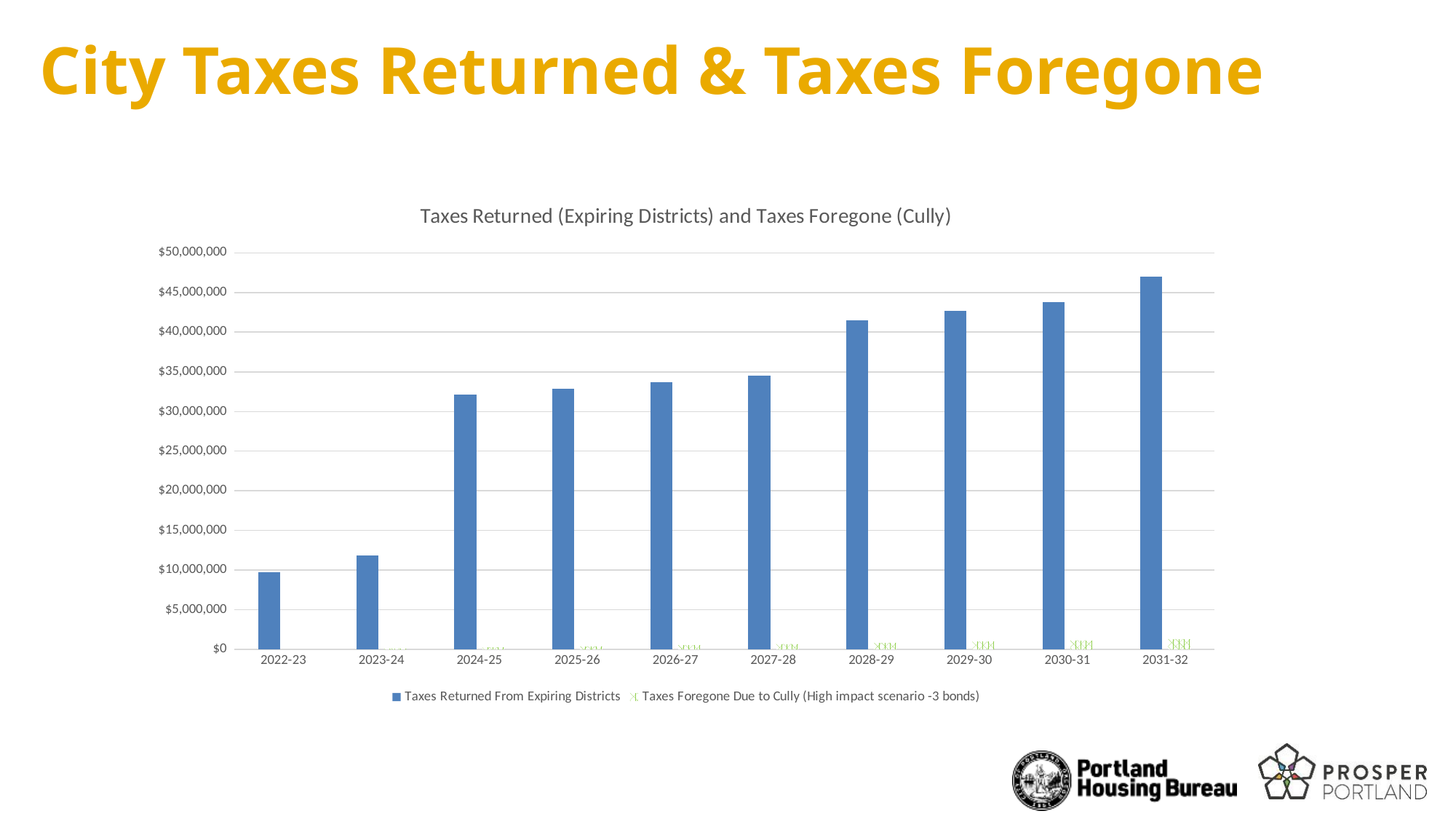
Which is larger for Taxes Returned From Expiring Districts: 2027-28 or 2028-29? 2028-29 Is the value for Taxes Returned From Expiring Districts in 2022-23 greater or less than $15,000,000? less Which fiscal year has the highest value for Taxes Returned From Expiring Districts? 2031-32 Is the value for Taxes Returned From Expiring Districts in 2030-31 greater or less than $45,000,000? less How many series does the chart's legend list? 2 How many fiscal years are shown on the x axis of the chart? 10 What kind of chart is shown on the slide? Bar chart Is the value for Taxes Returned From Expiring Districts in 2024-25 greater or less than $30,000,000? greater What is the title of the chart? Taxes Returned (Expiring Districts) and Taxes Foregone (Cully) Do the values for Taxes Returned From Expiring Districts rise or fall from 2022-23 to 2031-32? Rise Which fiscal year has the lowest value for Taxes Returned From Expiring Districts? 2022-23